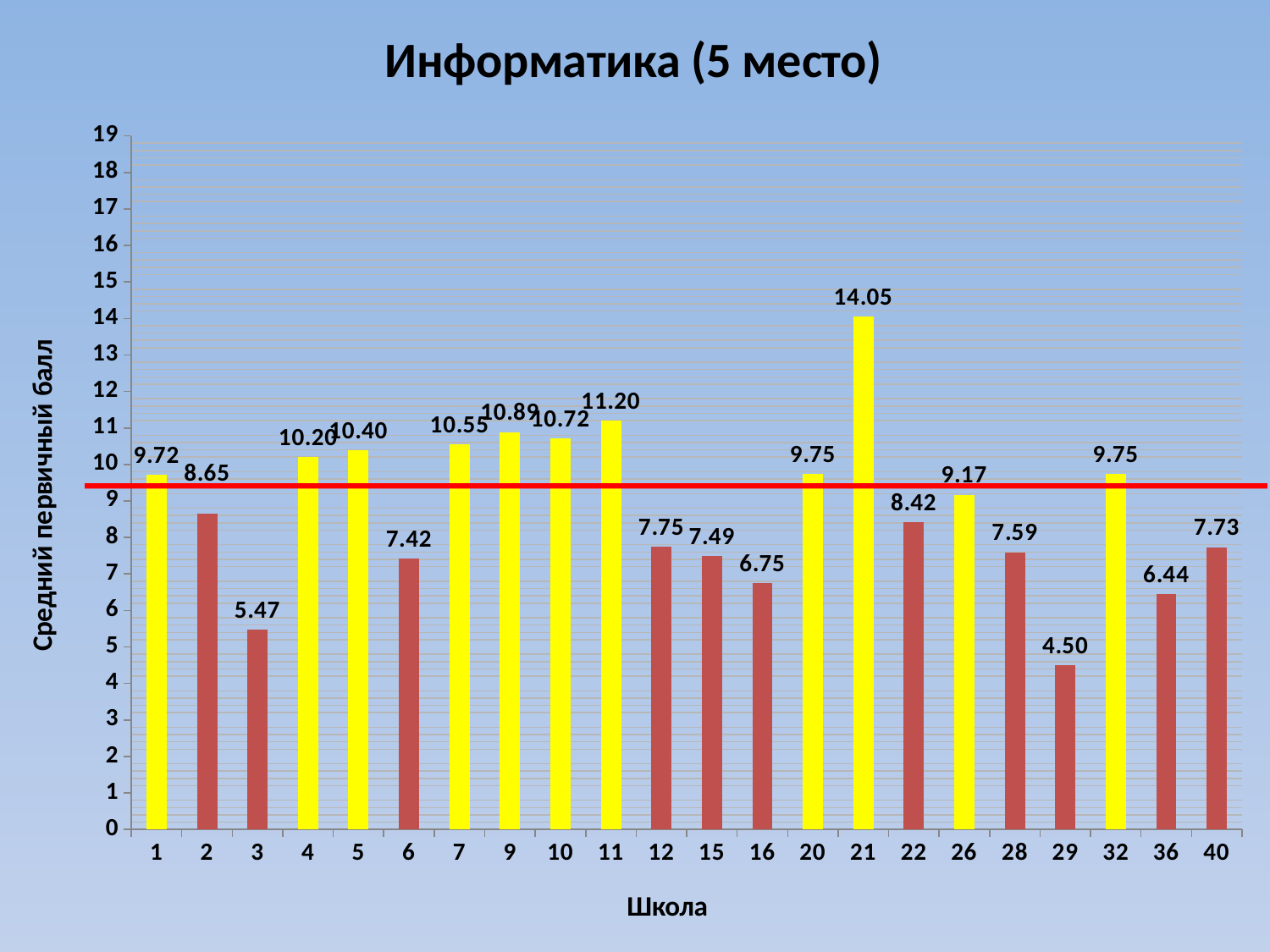
Which has a larger value, school 2 or school 3? school 2 Is the value for school 21 greater or less than 12? greater What is the value for school 29? 4.50 What is the value for school 21? 14.05 What is the value for school 11? 11.20 What is the difference between the values for school 21 and school 29? 9.55 Which school has the highest average score? 21 How many schools are shown on the x axis? 22 What is the difference between the values for school 11 and school 12? 3.45 What is the title of the vertical axis? Средний первичный балл Which school has the lowest average score? 29 What kind of chart is shown on the slide? bar chart